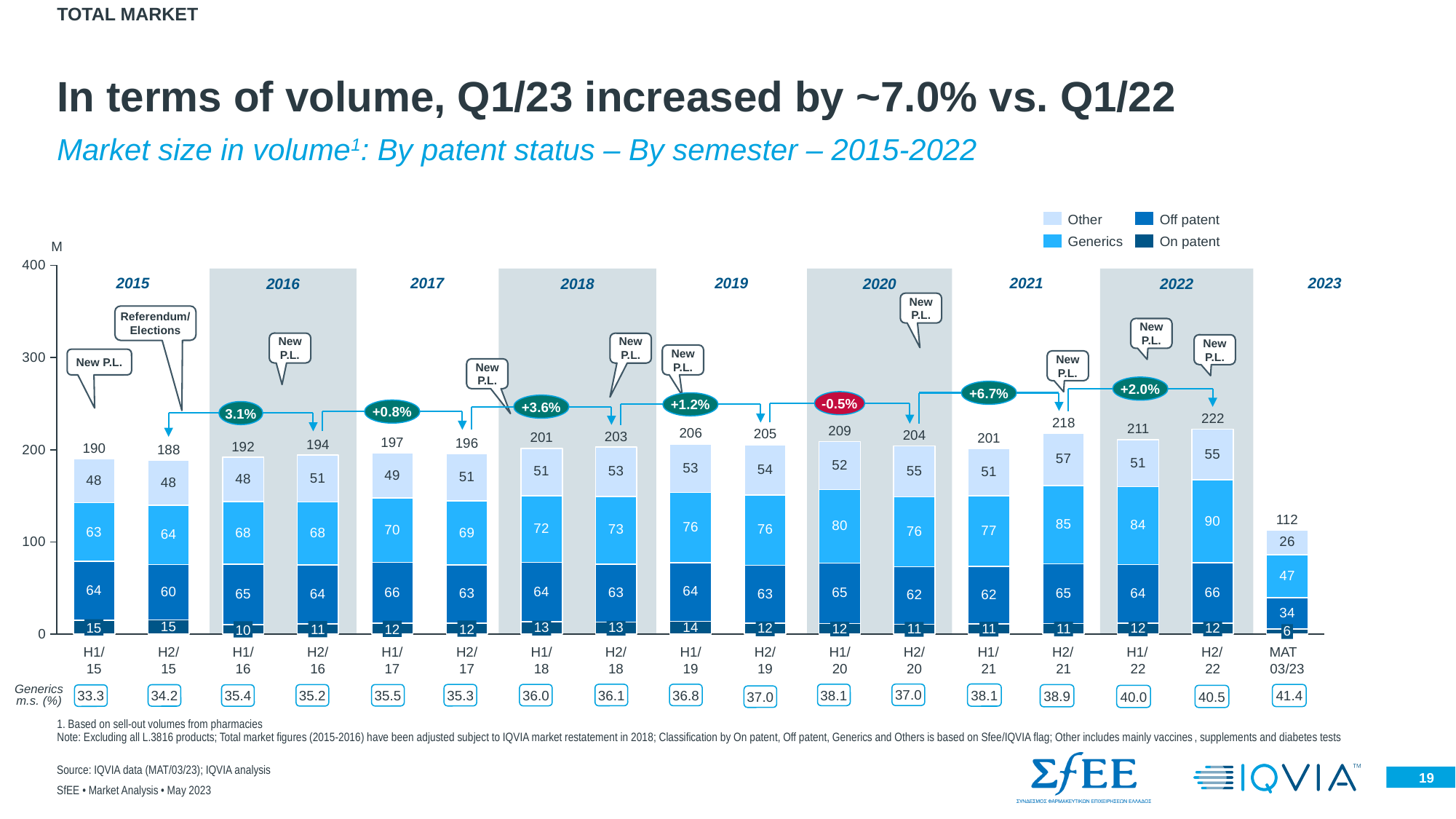
How many bars are plotted on the chart? 17 Which has the larger Off patent value, H1/15 or H2/15? H1/15 What is the difference between the total for H2/22 and the total for H1/22? 11 Does the Generics market share (%) row rise or fall from H1/15 to MAT 03/23? Rise What is the Generics value for H2/22? 90 Which bar has the lowest total volume? MAT 03/23 Which semester bar has the highest total volume? H2/22 What kind of chart is shown on the slide? Stacked bar chart What is the total market volume shown above the H1/20 bar? 209 How many series does the legend list? 4 What is the On patent value for H1/19? 14 What is the Generics market share (%) shown for MAT 03/23? 41.4